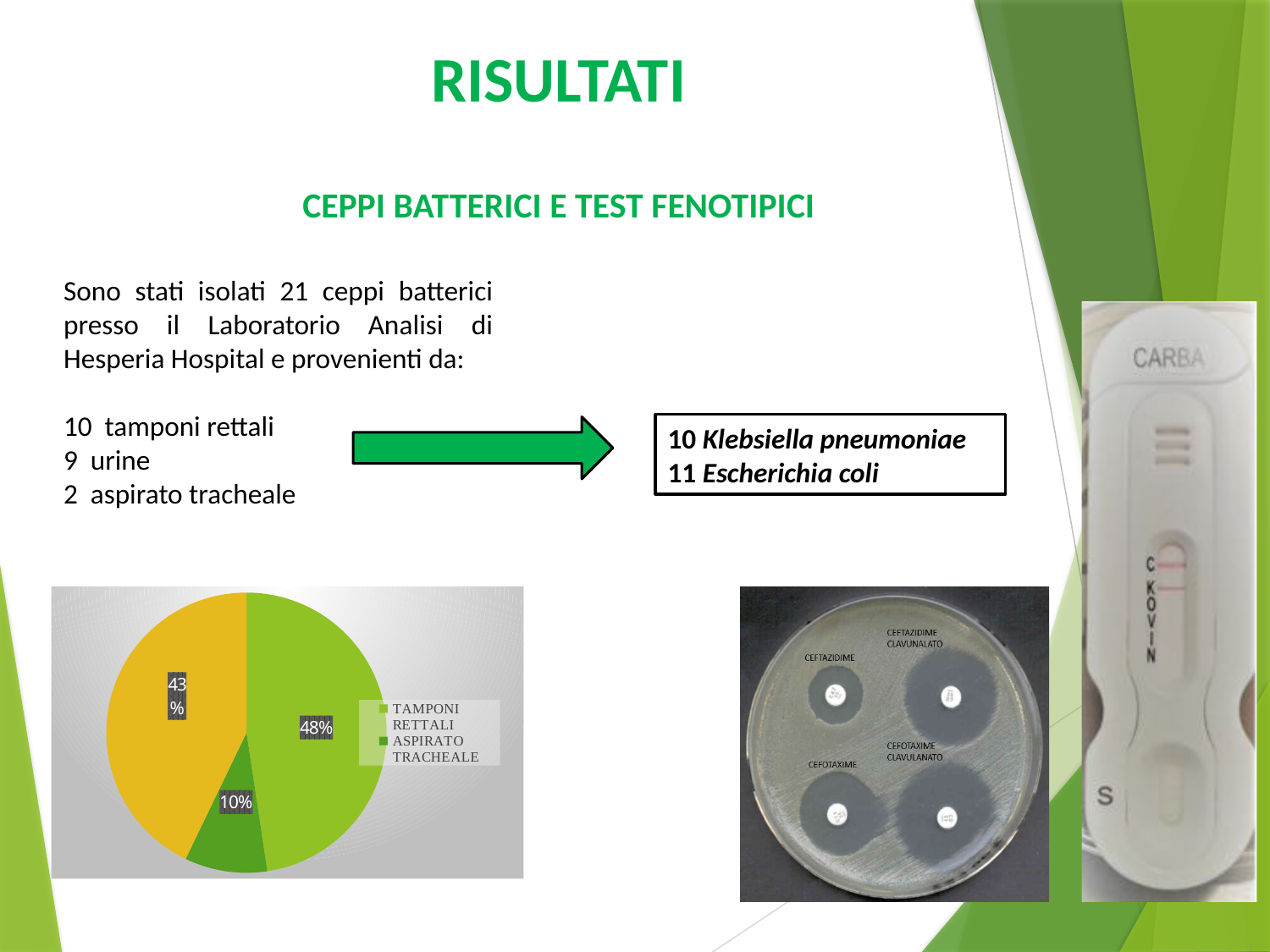
How many slices does the pie chart have? 3 What colour is the TAMPONI RETTALI slice in the pie chart? light green In the pie chart, what percentage is printed on the yellow slice? 43% Which slice of the pie chart is the smallest? ASPIRATO TRACHEALE In the pie chart, which is larger: TAMPONI RETTALI or ASPIRATO TRACHEALE? TAMPONI RETTALI In the pie chart, what is the difference in percentage points between the 48% slice and the 43% slice? 5% In the pie chart, what percentage is shown for ASPIRATO TRACHEALE? 10% What kind of chart is shown at the bottom left of the slide? pie chart Is the share for TAMPONI RETTALI in the pie chart greater or less than 50%? less Which slice of the pie chart is the largest? TAMPONI RETTALI In the pie chart, what percentage is shown for TAMPONI RETTALI? 48% In the pie chart, what is the difference in percentage points between TAMPONI RETTALI and ASPIRATO TRACHEALE? 38%